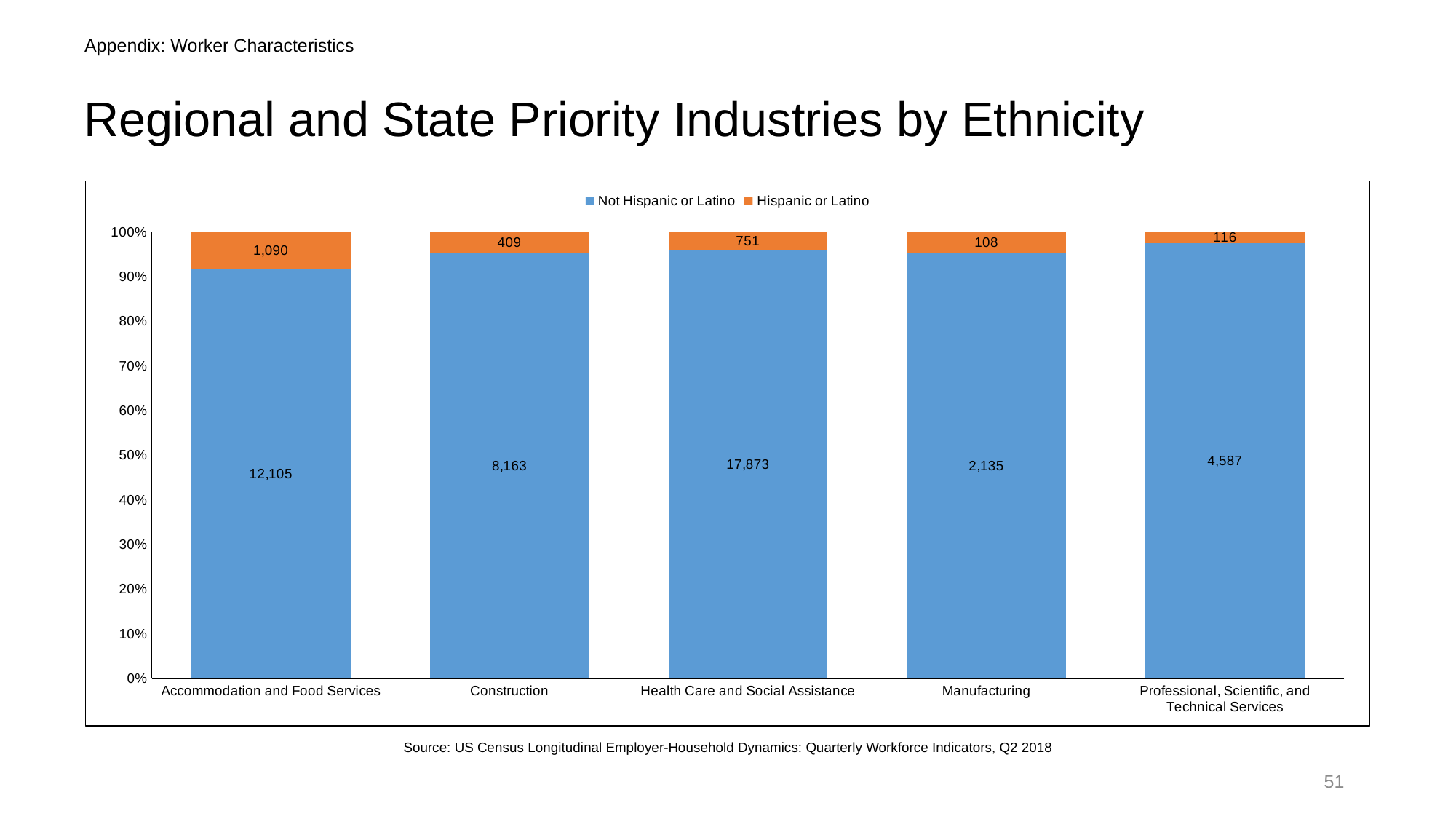
How many industries are shown on the x axis? 5 How many series does the legend list? 2 What is the difference between the Not Hispanic or Latino values for Accommodation and Food Services and Construction? 3,942 Which industry has the lowest Hispanic or Latino value? Manufacturing What is the Not Hispanic or Latino value for Health Care and Social Assistance? 17,873 What kind of chart is shown on the slide? Stacked bar chart Which industry has the highest Not Hispanic or Latino value? Health Care and Social Assistance What is the Hispanic or Latino value for Manufacturing? 108 What is the Hispanic or Latino value for Accommodation and Food Services? 1,090 Which colour represents the Hispanic or Latino series? Orange What is the total of the two series for Manufacturing? 2,243 Which is larger, the Hispanic or Latino value for Construction or for Professional, Scientific, and Technical Services? Construction